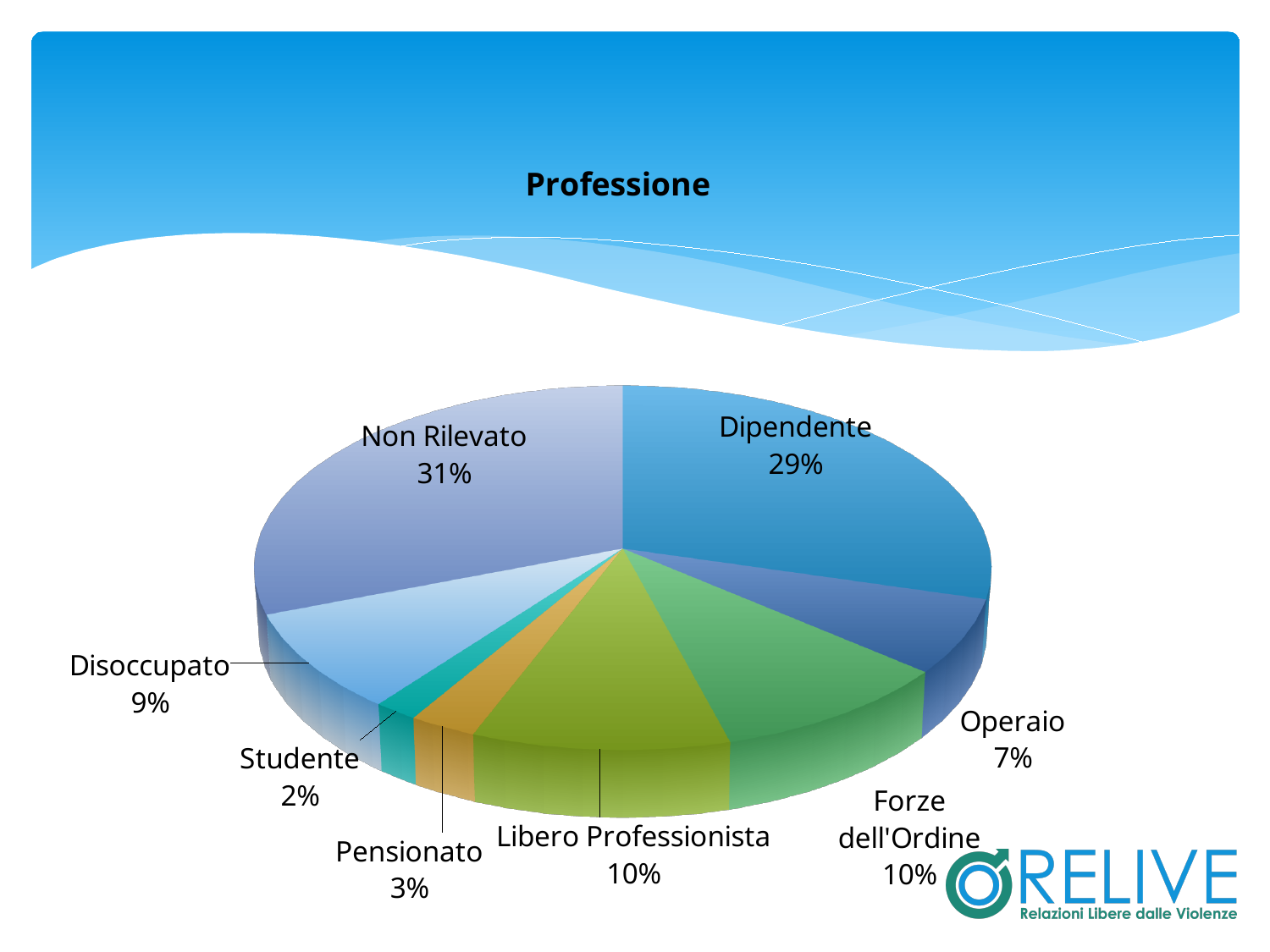
What percentage is shown for Disoccupato? 9% What is the title of the chart? Professione What percentage is shown for Forze dell'Ordine? 10% Which category has the largest share of the pie? Non Rilevato What percentage is shown for Dipendente? 29% Which category has the smallest share of the pie? Studente What percentage is shown for Non Rilevato? 31% What is the difference between the shares of Pensionato and Studente? 1% How many categories are shown in the pie chart? 8 What kind of chart is shown on the slide? pie chart What is the difference between the shares of Non Rilevato and Dipendente? 2% Which is larger, the share for Operaio or the share for Disoccupato? Disoccupato